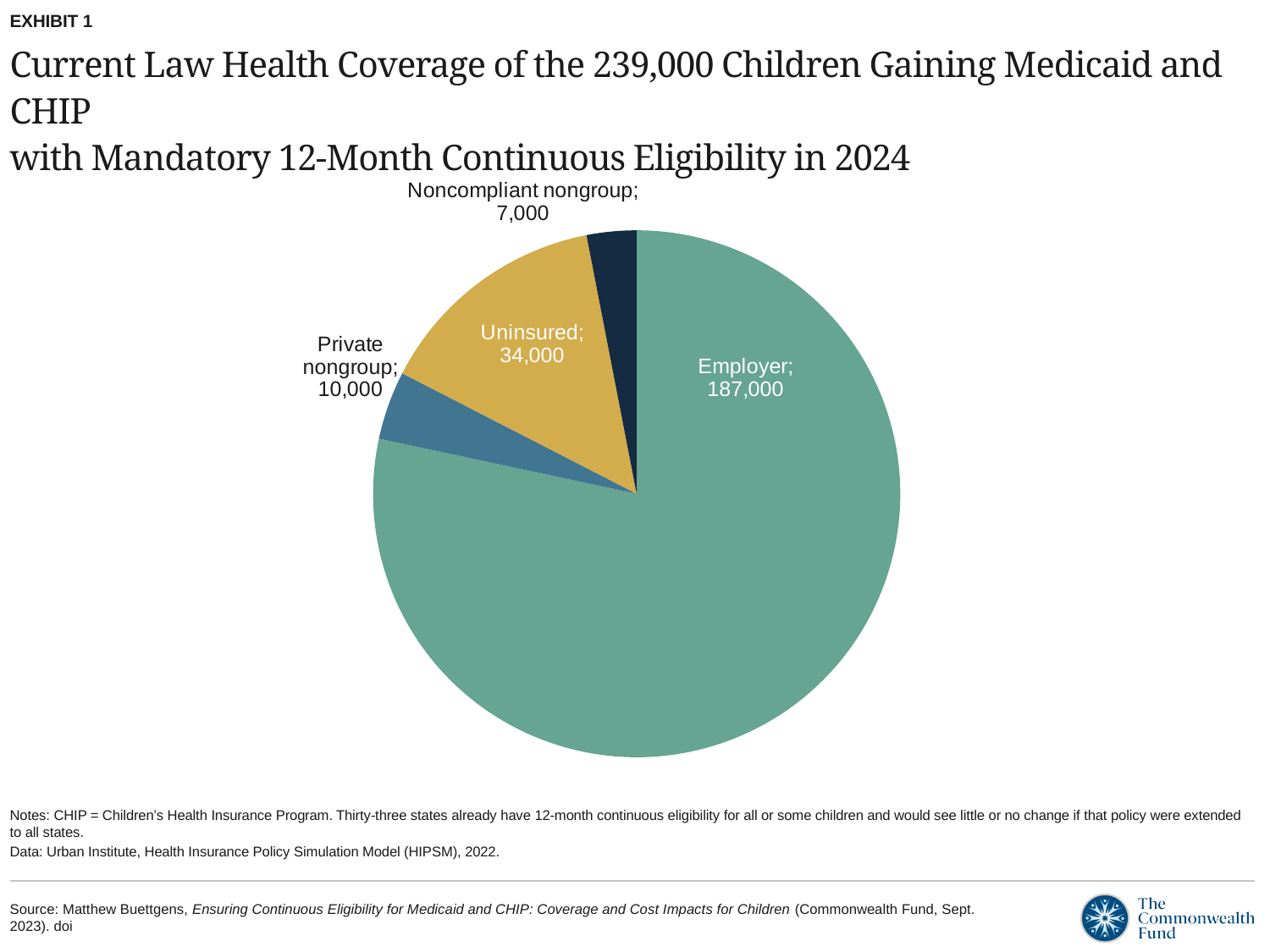
What is the difference between the Uninsured and Private nongroup values? 24,000 What is the value shown for Noncompliant nongroup? 7,000 What is the value shown for Private nongroup? 10,000 How many children gaining coverage currently have employer coverage? 187,000 Which coverage category has the largest slice of the pie? Employer What is the difference between the Employer and Uninsured values? 153,000 What colour is the Uninsured slice? Gold/yellow What is the value shown for the Uninsured slice? 34,000 How many slices does the pie chart have? 4 Which coverage category has the smallest slice of the pie? Noncompliant nongroup What type of chart is shown on the slide? Pie chart Which is larger, the Private nongroup slice or the Noncompliant nongroup slice? Private nongroup